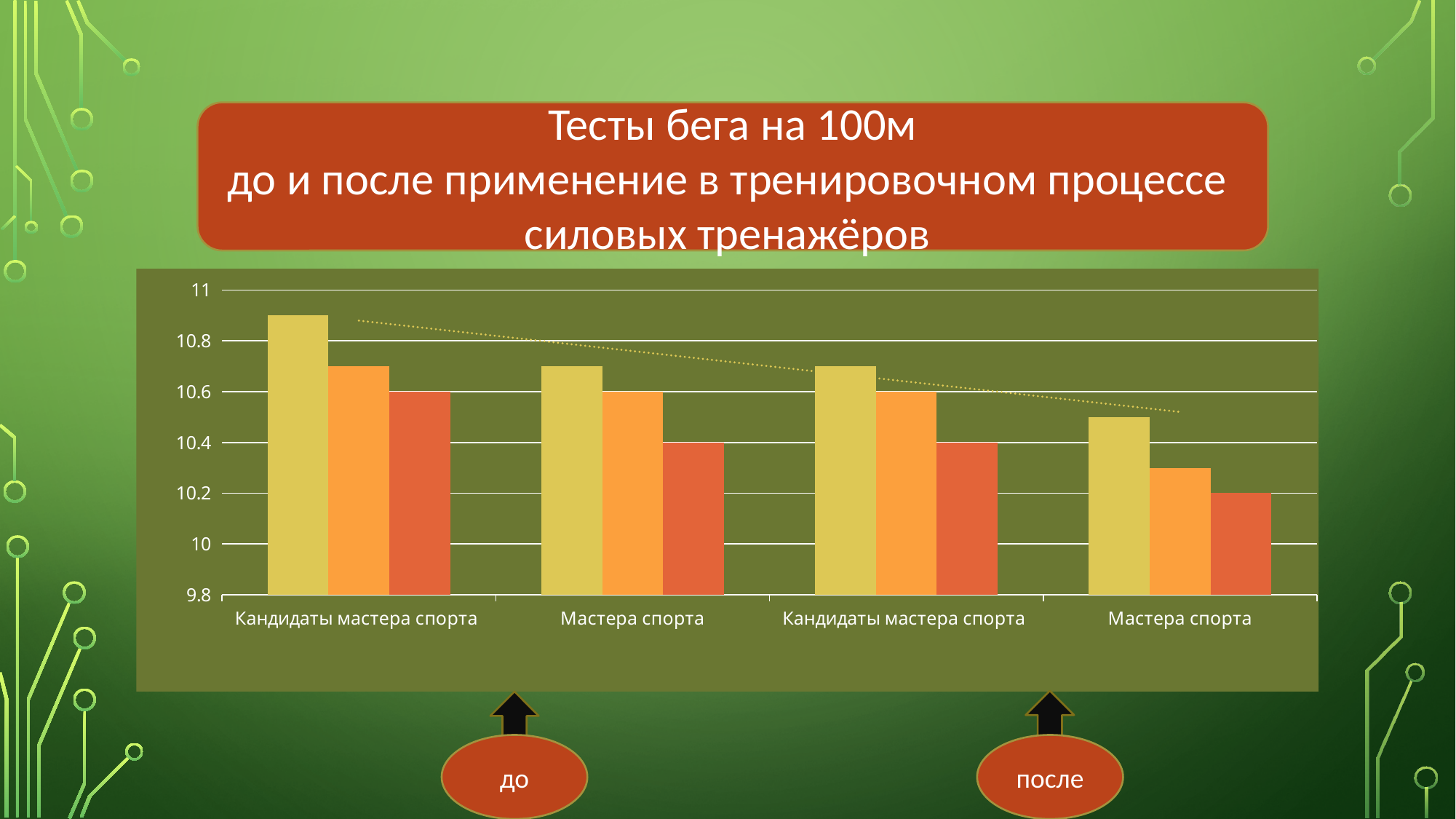
Is the value of the yellow (leftmost) bar in the first group, 'Кандидаты мастера спорта' under 'до', greater or less than 10.8? greater What is the value of the orange (middle) bar in the second group, 'Мастера спорта' under 'до'? 10.6 What kind of chart is shown on the slide? bar chart Do the yellow bars generally rise or fall from left to right along the x axis? fall Which category group has the tallest yellow bar? Кандидаты мастера спорта (до) Which is larger: the red bar in the first group ('Кандидаты мастера спорта', до) or the red bar in the last group ('Мастера спорта', после)? the first group (Кандидаты мастера спорта, до) What is the value of the red (rightmost) bar in the last group, 'Мастера спорта' under 'после'? 10.2 How many category groups are shown along the x axis of the chart? 4 What is the difference between the red bar in the first group (10.6) and the red bar in the last group (10.2)? 0.4 Is the value of the yellow (leftmost) bar in the last group, 'Мастера спорта' under 'после', greater or less than 10.6? less How many bars are there in each category group of the chart? 3 What is the value of the red (rightmost) bar in the first group, 'Кандидаты мастера спорта' under 'до'? 10.6